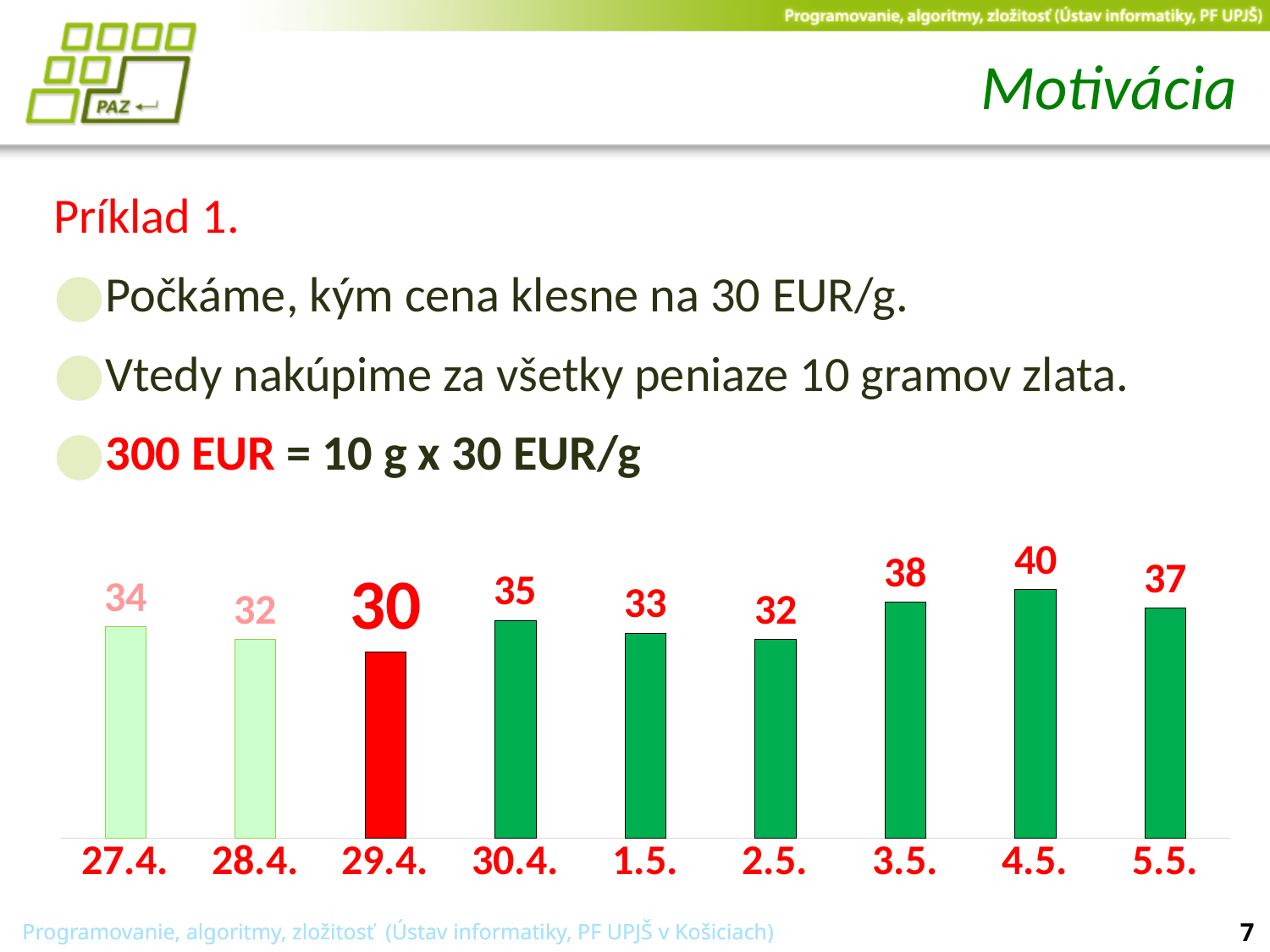
Which date has the lowest value? 29.4. What is the difference between the values for 3.5. and 2.5.? 6 What is the value for 27.4.? 34 What kind of chart is shown? bar chart Which bar is coloured red? 29.4. Do the values rise or fall from 2.5. to 4.5.? rise What is the value for 29.4.? 30 What is the value for 4.5.? 40 How many dates are shown on the x axis? 9 What is the difference between the values for 4.5. and 29.4.? 10 Which date has the highest value? 4.5. Which is larger, the value for 30.4. or the value for 1.5.? 30.4.